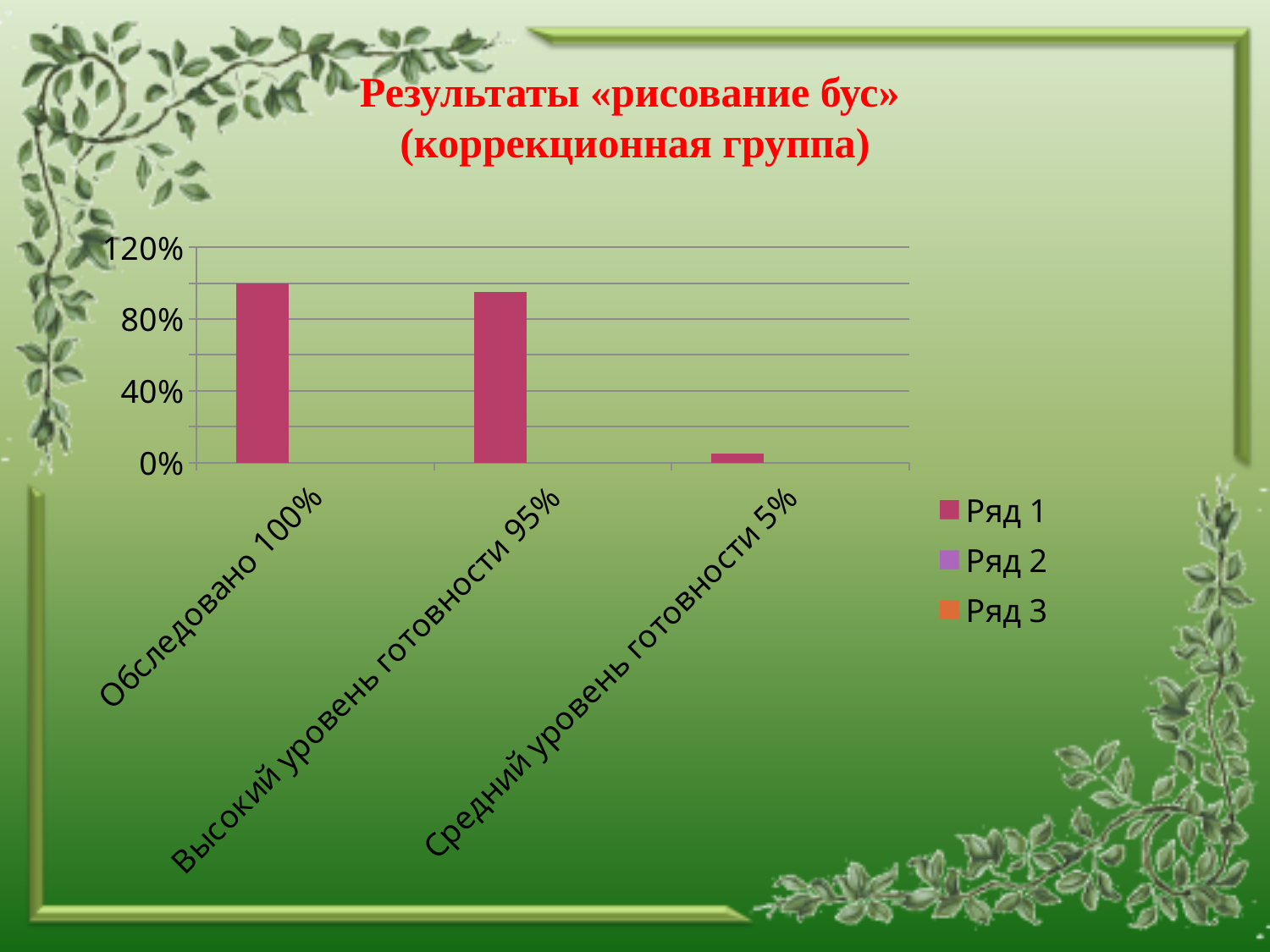
Which category has the highest bar? Обследовано 100% What value is shown for the category "Высокий уровень готовности"? 95% What is the difference between the values for "Высокий уровень готовности" and "Средний уровень готовности"? 90% Which category has the lowest bar? Средний уровень готовности 5% What value is shown for the category "Средний уровень готовности"? 5% Is the value for "Средний уровень готовности" greater or less than 40%? less What is the title of the chart on the slide? Результаты «рисование бус» (коррекционная группа) How many series does the legend list? 3 Is the value for "Высокий уровень готовности" greater or less than 80%? greater How many categories are shown on the x axis of the chart? 3 What value is shown for the category "Обследовано"? 100% What kind of chart is shown on the slide? bar chart